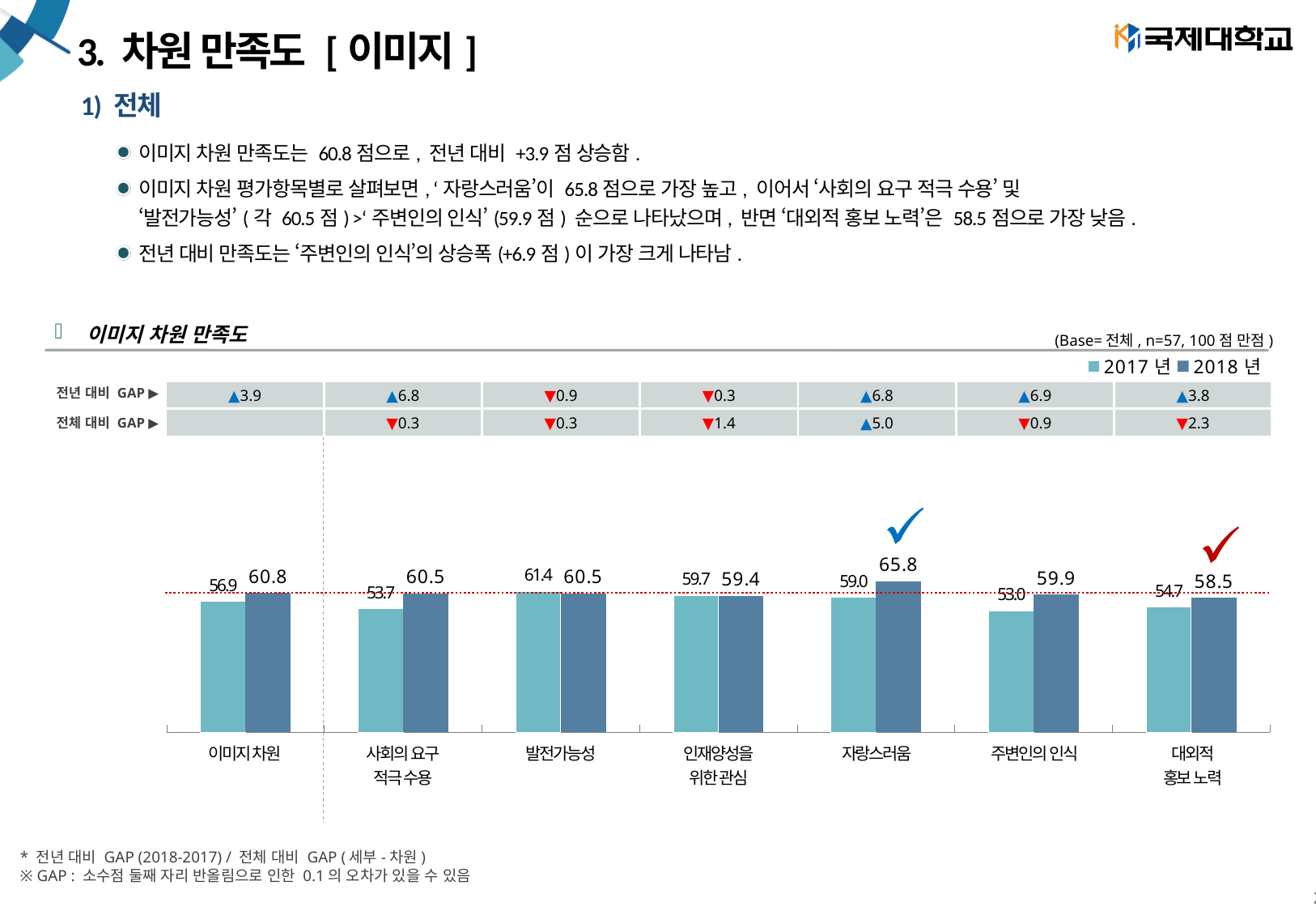
How many series does the chart legend list? 2 Which is larger for 발전가능성: the 2017년 value or the 2018년 value? 2017년 What are the two series named in the chart legend? 2017년 and 2018년 What is the 2017년 value for 주변인의 인식? 53.0 How many categories are shown on the x axis of the chart? 7 Which category has the lowest 2017년 value? 주변인의 인식 What is the 2018년 value for 대외적 홍보 노력? 58.5 What is the difference between the 2018년 and 2017년 values for 사회의 요구 적극 수용? 6.8 Which category has the highest 2018년 value? 자랑스러움 What is the 2018년 value for 자랑스러움? 65.8 What is the 2017년 value for 이미지 차원? 56.9 What kind of chart is shown on the slide? bar chart